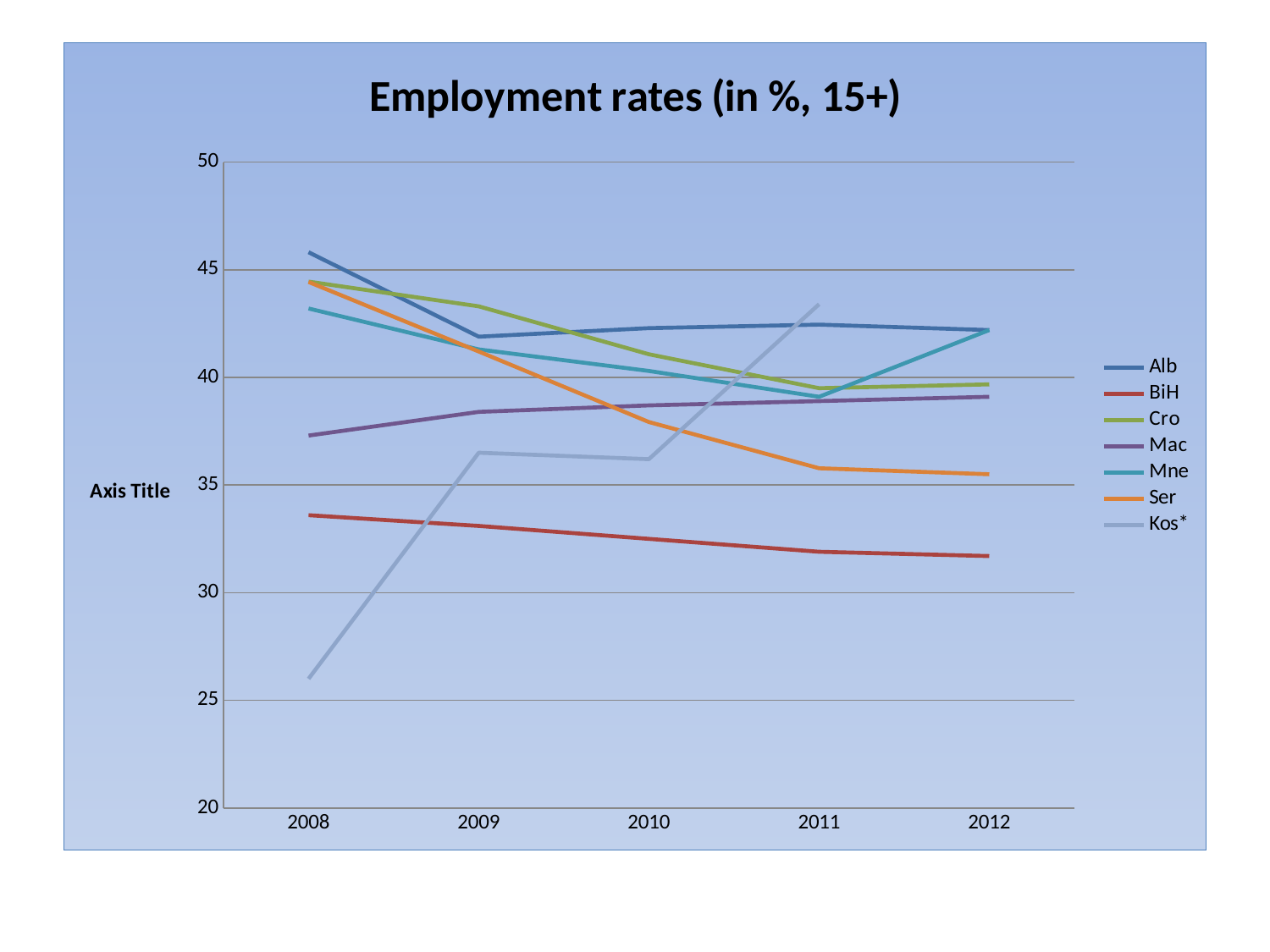
What kind of chart is shown on the slide? line chart Is the value for BiH in 2008 greater or less than 35? less Which series has the lowest value in 2008? Kos* Which series has the lowest value in 2012? BiH How many series does the legend list? 7 How many years are shown on the x axis? 5 Is the value for Alb in 2008 greater or less than 45? greater What is the title of the chart? Employment rates (in %, 15+) Does the value for BiH rise or fall from 2008 to 2012? fall Does the value for Ser rise or fall from 2008 to 2012? fall Is the value for Kos* in 2008 greater or less than 30? less Does the value for Mac rise or fall from 2008 to 2012? rise